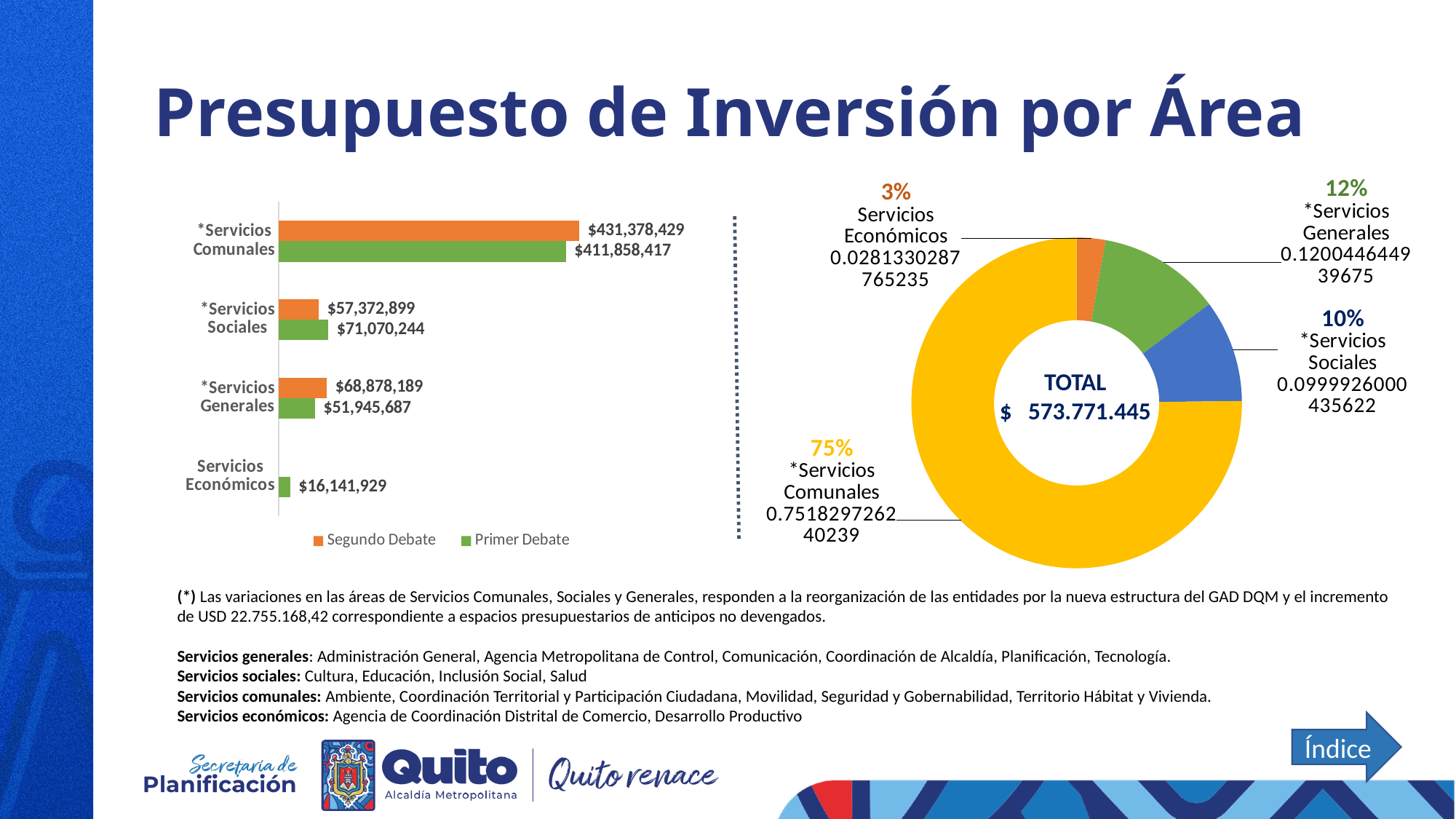
In the bar chart on the left, what is the Primer Debate value for *Servicios Generales? $51,945,687 In the bar chart on the left, what is the Primer Debate value for *Servicios Sociales? $71,070,244 In the bar chart on the left, what is the Segundo Debate value for *Servicios Comunales? $431,378,429 What total is shown in the centre of the donut chart on the right? $ 573.771.445 In the bar chart on the left, what is the difference between the Segundo Debate and Primer Debate values for *Servicios Comunales? $19,520,012 In the donut chart on the right, what share does *Servicios Comunales represent? 75% In the bar chart on the left, what value is shown for Servicios Económicos? $16,141,929 In the bar chart on the left, how many series does the legend list? 2 In the bar chart on the left, which category has the highest Segundo Debate value? *Servicios Comunales In the donut chart on the right, which category has the smallest share? Servicios Económicos What type of chart is shown on the left side of the slide? Bar chart In the bar chart on the left, which is larger for *Servicios Sociales: the Segundo Debate value or the Primer Debate value? Primer Debate